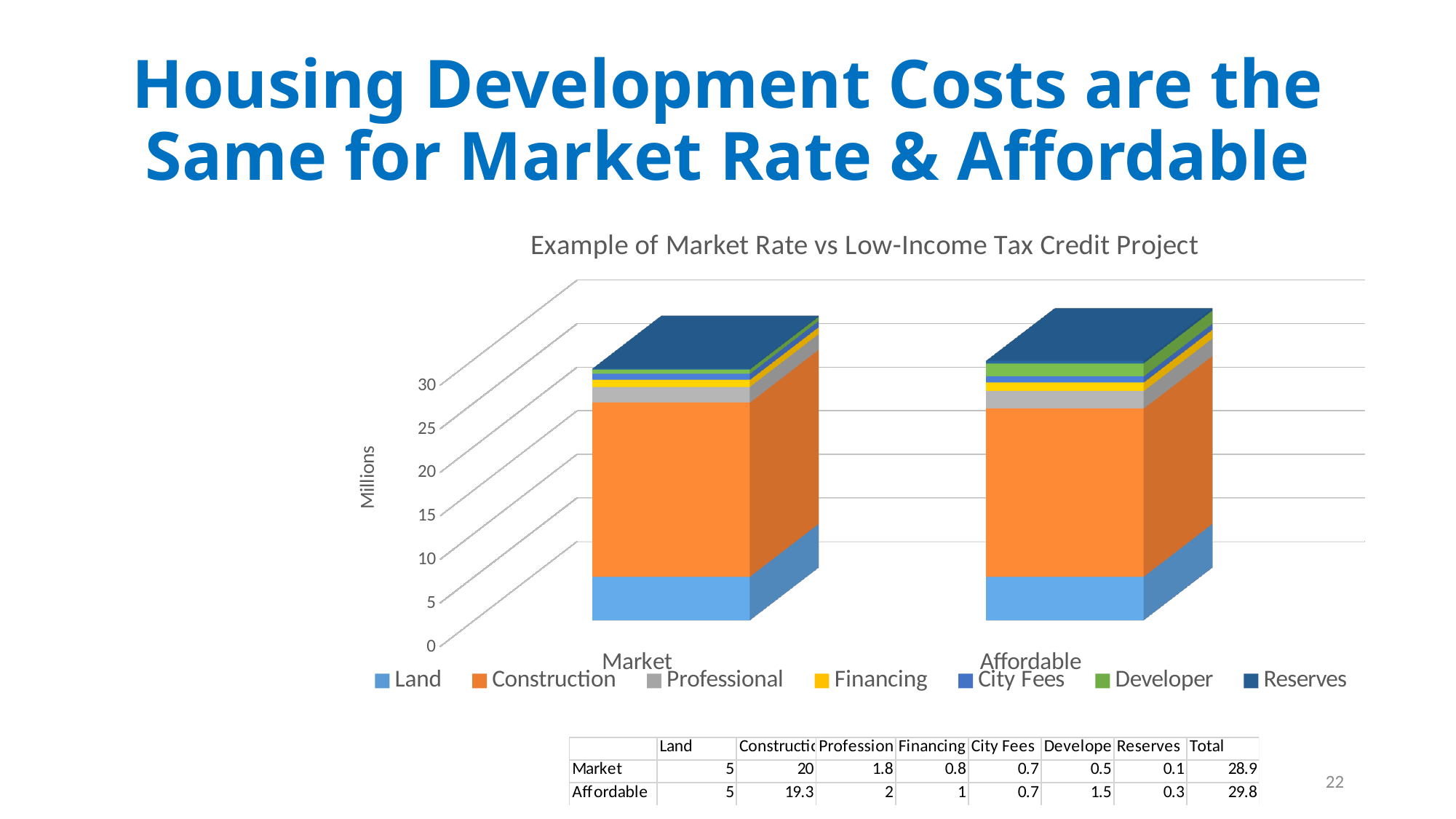
What is the Financing value for Market? 0.8 How many categories are plotted on the x axis of the chart? 2 What is the Construction value for Market? 20 What is the difference between the Construction values for Market and Affordable? 0.7 What kind of chart is shown on the slide? Stacked bar chart What is the total of the Market stacked bar? 28.9 Which series is the largest segment in the Market bar? Construction What is the total of the Affordable stacked bar? 29.8 Which category has the larger Developer value, Market or Affordable? Affordable What unit is shown on the y axis label of the chart? Millions How many series does the chart legend list? 7 What is the Developer value for Affordable? 1.5